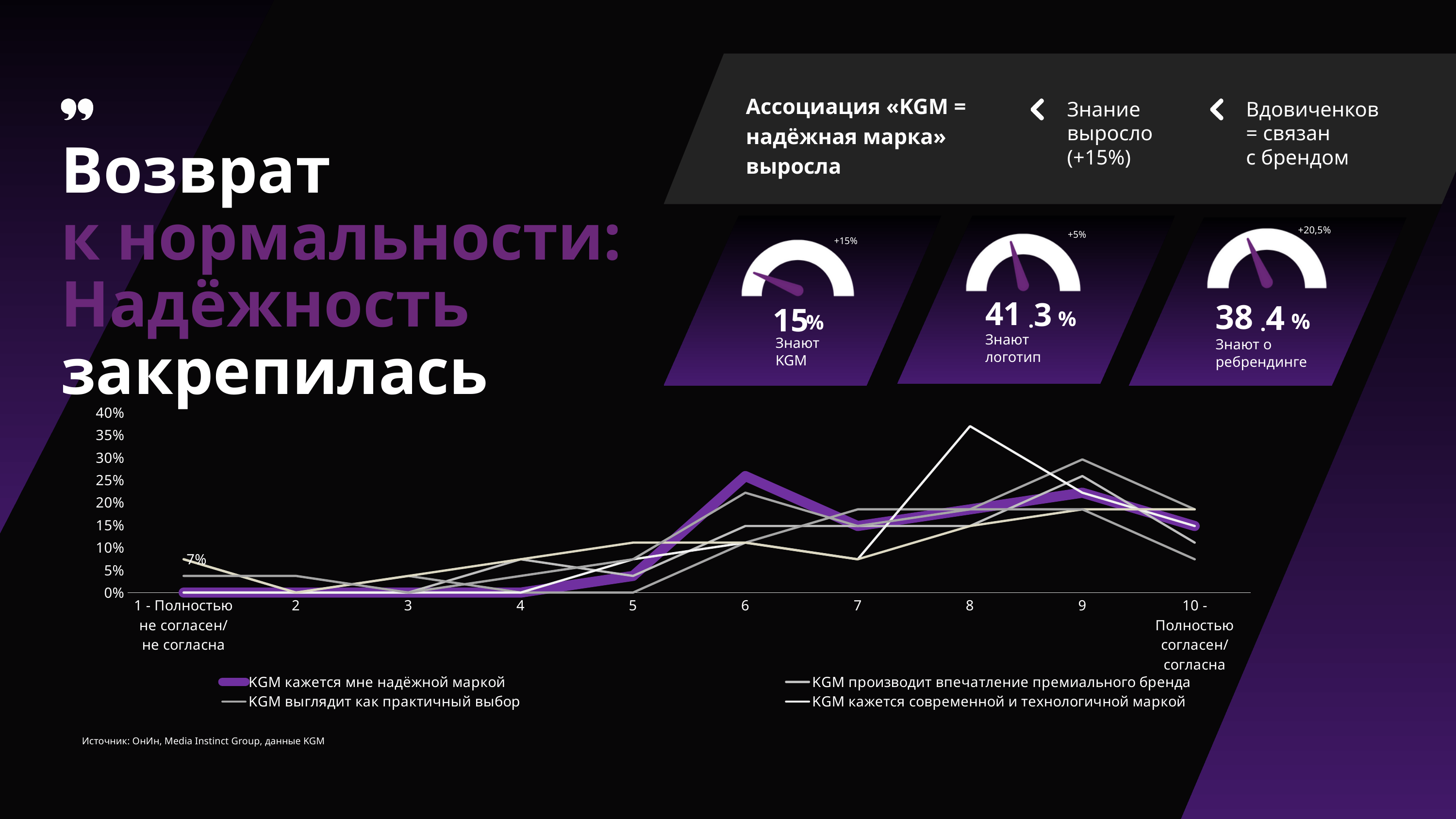
What kind of chart is the chart at the bottom of the slide? line chart How many points are on the x axis of the line chart? 10 In the gauge charts, what value is shown for "Знают о ребрендинге"? 38.4% In the line chart, is the value of "KGM кажется мне надёжной маркой" at point 10 greater or less than 20%? less In the line chart, is the value of "KGM кажется мне надёжной маркой" at point 6 greater or less than 20%? greater In the line chart, at point 8, which series is higher: "KGM кажется современной и технологичной маркой" or "KGM кажется мне надёжной маркой"? KGM кажется современной и технологичной маркой In the gauge charts, what value is shown for "Знают KGM"? 15% In the line chart, at which x-axis point does "KGM кажется мне надёжной маркой" reach its highest value? 6 In the line chart, what colour is the line for "KGM кажется мне надёжной маркой"? purple In the line chart, is the value of "KGM кажется современной и технологичной маркой" at point 8 greater or less than 30%? greater In the line chart, does "KGM кажется мне надёжной маркой" rise or fall from point 1 to point 6? rise How many series does the legend of the line chart list? 4